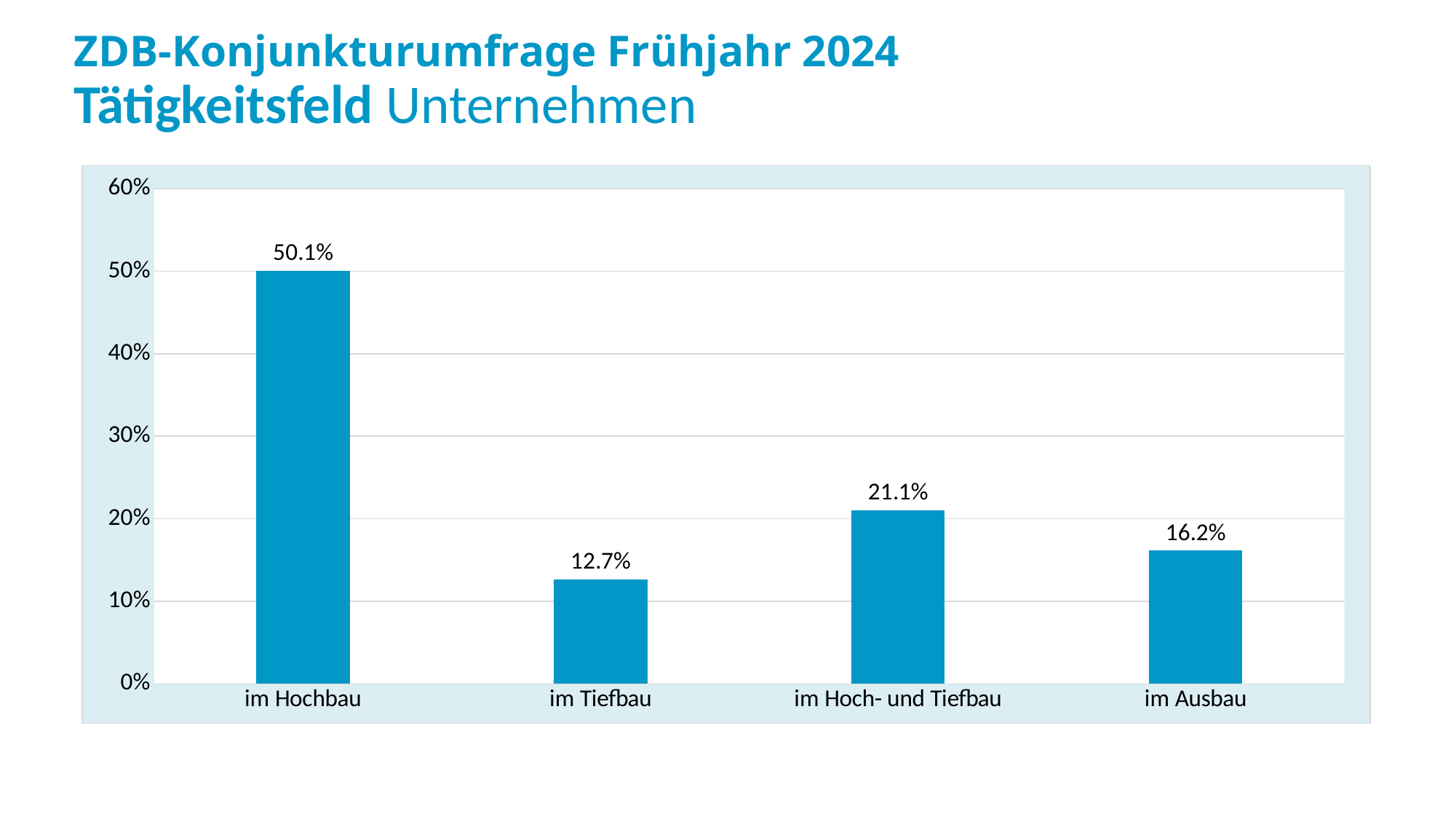
What is the difference between the values for "im Hochbau" and "im Tiefbau"? 37.4% What is the value for "im Tiefbau"? 12.7% How many categories are shown on the x axis? 4 What kind of chart is shown on the slide? bar chart What is the value for "im Ausbau"? 16.2% What is the value for "im Hoch- und Tiefbau"? 21.1% Which is larger, the value for "im Ausbau" or the value for "im Tiefbau"? im Ausbau Which category has the lowest value? im Tiefbau What is the value for "im Hochbau"? 50.1% Is the value for "im Hoch- und Tiefbau" greater or less than 20%? greater What is the difference between the values for "im Hoch- und Tiefbau" and "im Ausbau"? 4.9% Which category has the highest value? im Hochbau